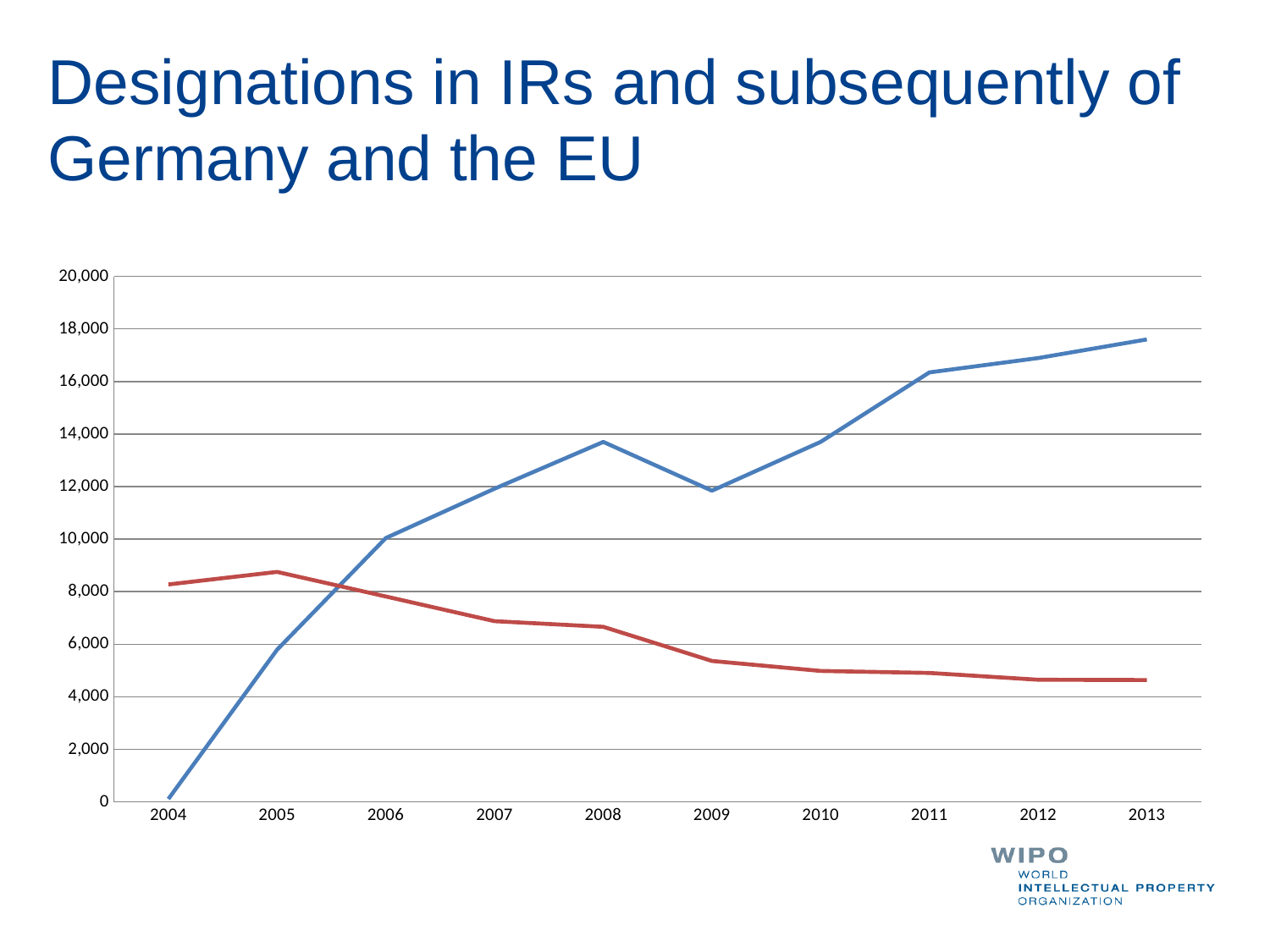
What kind of chart is shown on the slide? line chart In which year does the red line reach its highest value? 2005 In which year does the blue line have its lowest value? 2004 How many years are shown on the x axis of the chart? 10 In which year does the blue line reach its highest value? 2013 Is the value of the blue line in 2013 greater or less than 16,000? greater Is the value of the blue line in 2004 greater or less than 2,000? less Is the value of the blue line in 2009 greater or less than 10,000? greater What is the title of the slide containing the chart? Designations in IRs and subsequently of Germany and the EU Does the red line generally rise or fall from 2005 to 2013? fall In 2004, which line has the higher value, the blue line or the red line? the red line